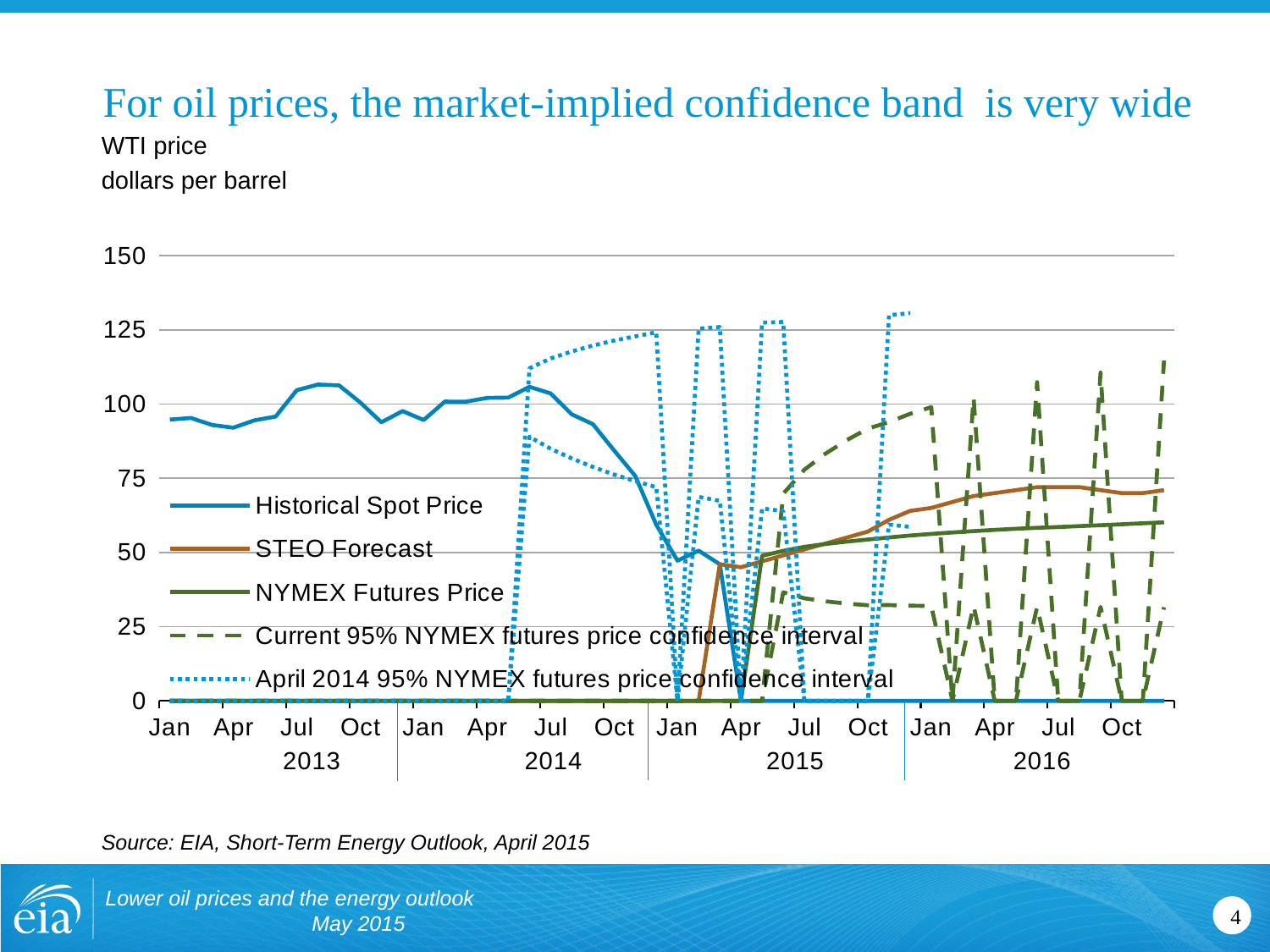
How many series does the legend list? 5 How many years are labelled along the x axis? 4 What is the title of the slide's chart? For oil prices, the market-implied confidence band is very wide Does the Historical Spot Price rise or fall between Jul 2014 and Jan 2015? fall Is the NYMEX Futures Price at the end of 2016 greater or less than 75? less At the end of 2016, which is higher: the STEO Forecast or the NYMEX Futures Price? STEO Forecast Is the Historical Spot Price in Jan 2013 greater or less than 75? greater Is the Historical Spot Price in Jan 2015 greater or less than 75? less What unit is the y axis measured in, according to the subtitle? dollars per barrel What kind of chart is shown on the slide? line chart